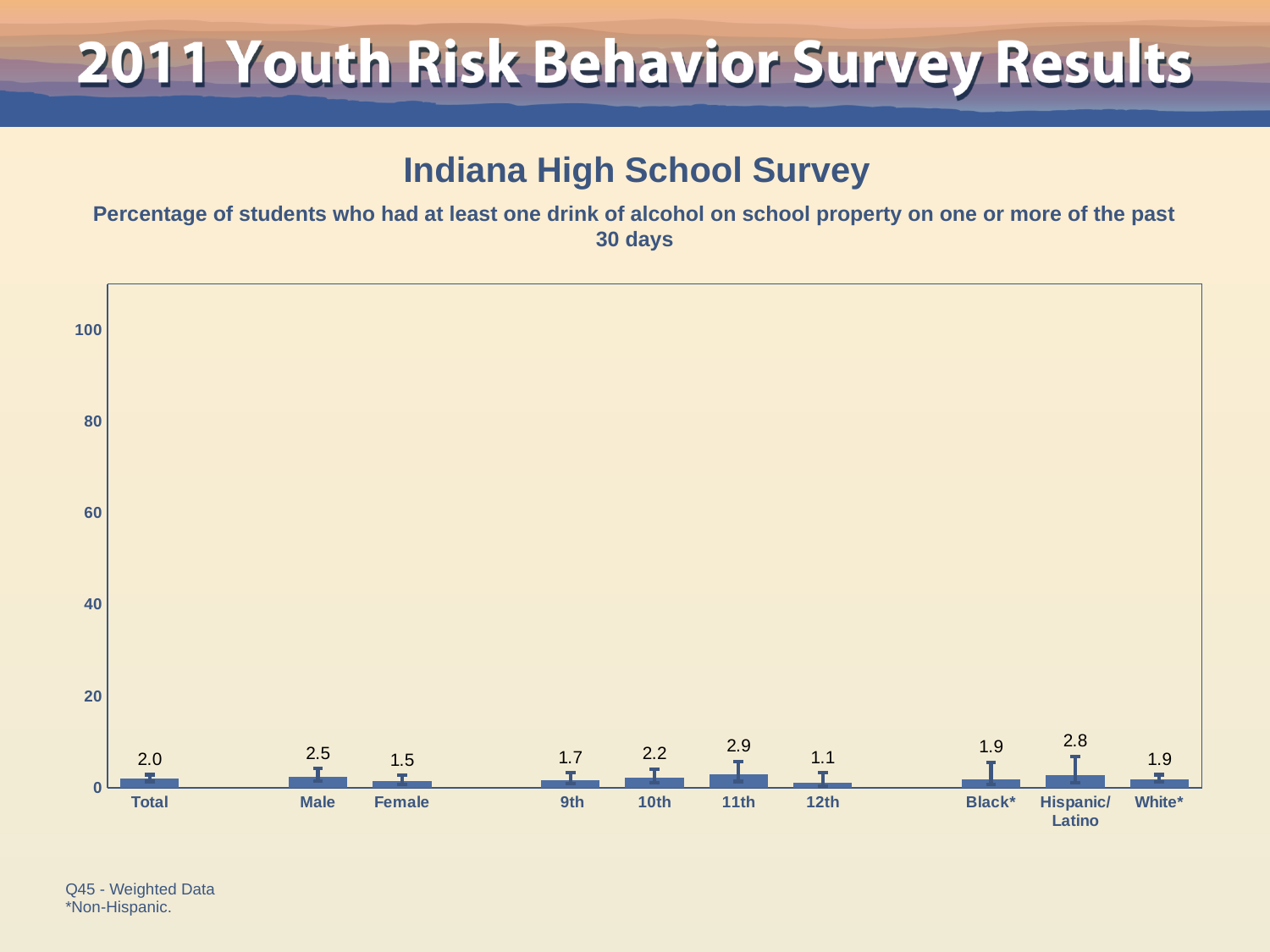
What kind of chart is this? bar chart Which is larger, the value for 10th or the value for 12th? 10th What is the highest tick value shown on the y axis? 100 Do the values rise or fall from 9th to 11th grade? rise Is the value for 11th greater or less than 20? less What is the value for Total? 2.0 What is the value for Male? 2.5 Which category has the lowest value? 12th What is the difference between the values for Male and Female? 1.0 Which category has the highest value? 11th How many categories are shown on the x axis? 10 What is the value for Hispanic/Latino? 2.8